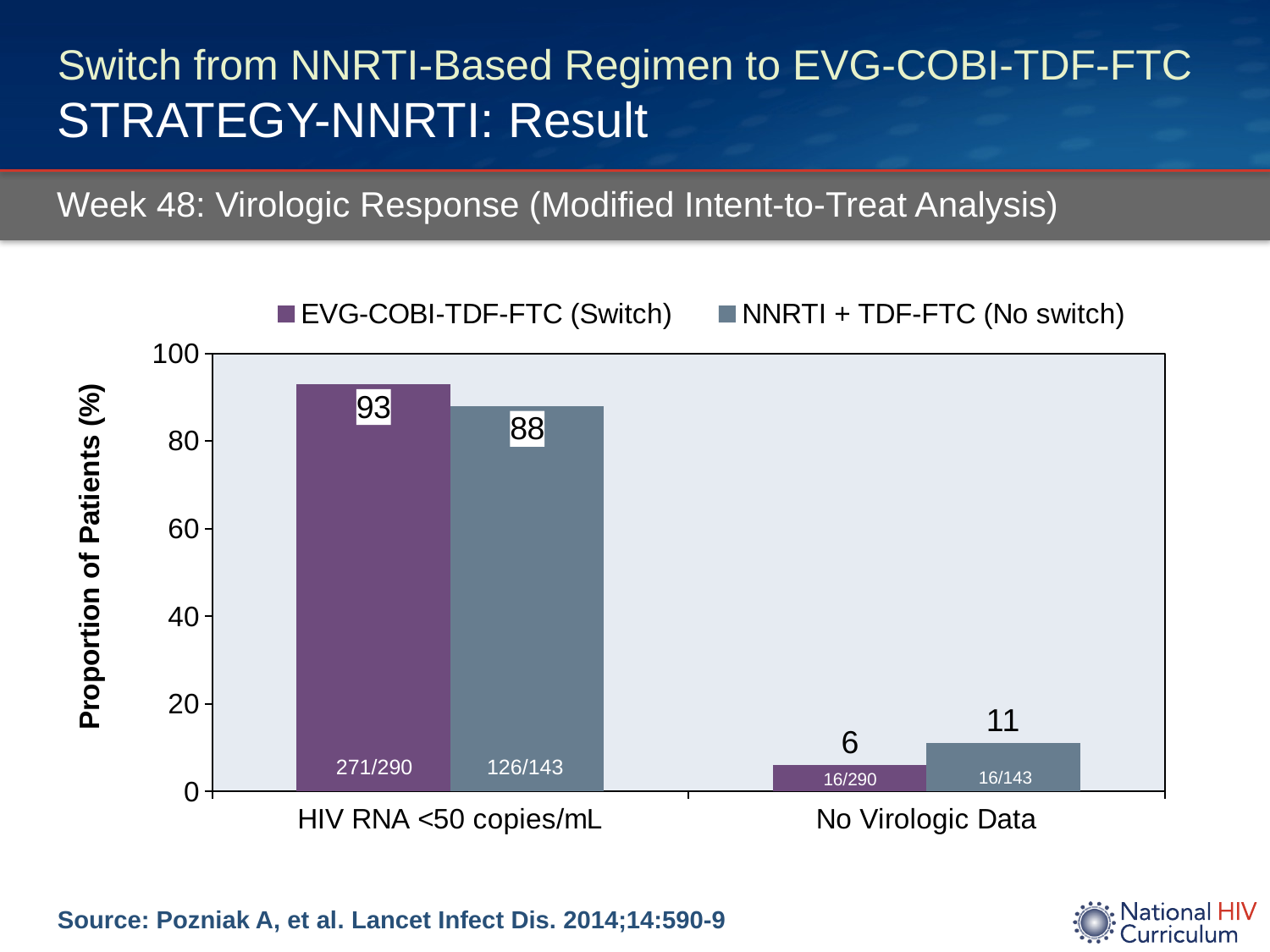
What is the value for EVG-COBI-TDF-FTC (Switch) in the HIV RNA <50 copies/mL category? 93 What fraction of patients is shown inside the NNRTI + TDF-FTC (No switch) bar for No Virologic Data? 16/143 Which series has the higher value in the HIV RNA <50 copies/mL category? EVG-COBI-TDF-FTC (Switch) What is the value for EVG-COBI-TDF-FTC (Switch) in the No Virologic Data category? 6 What is the value for NNRTI + TDF-FTC (No switch) in the HIV RNA <50 copies/mL category? 88 What kind of chart is shown on the slide? Bar chart Which series has the higher value in the No Virologic Data category? NNRTI + TDF-FTC (No switch) What is the difference between the two series in the No Virologic Data category? 5 What fraction of patients is shown inside the EVG-COBI-TDF-FTC (Switch) bar for HIV RNA <50 copies/mL? 271/290 How many series does the legend list? 2 What is the value for NNRTI + TDF-FTC (No switch) in the No Virologic Data category? 11 What is the difference between the two series in the HIV RNA <50 copies/mL category? 5